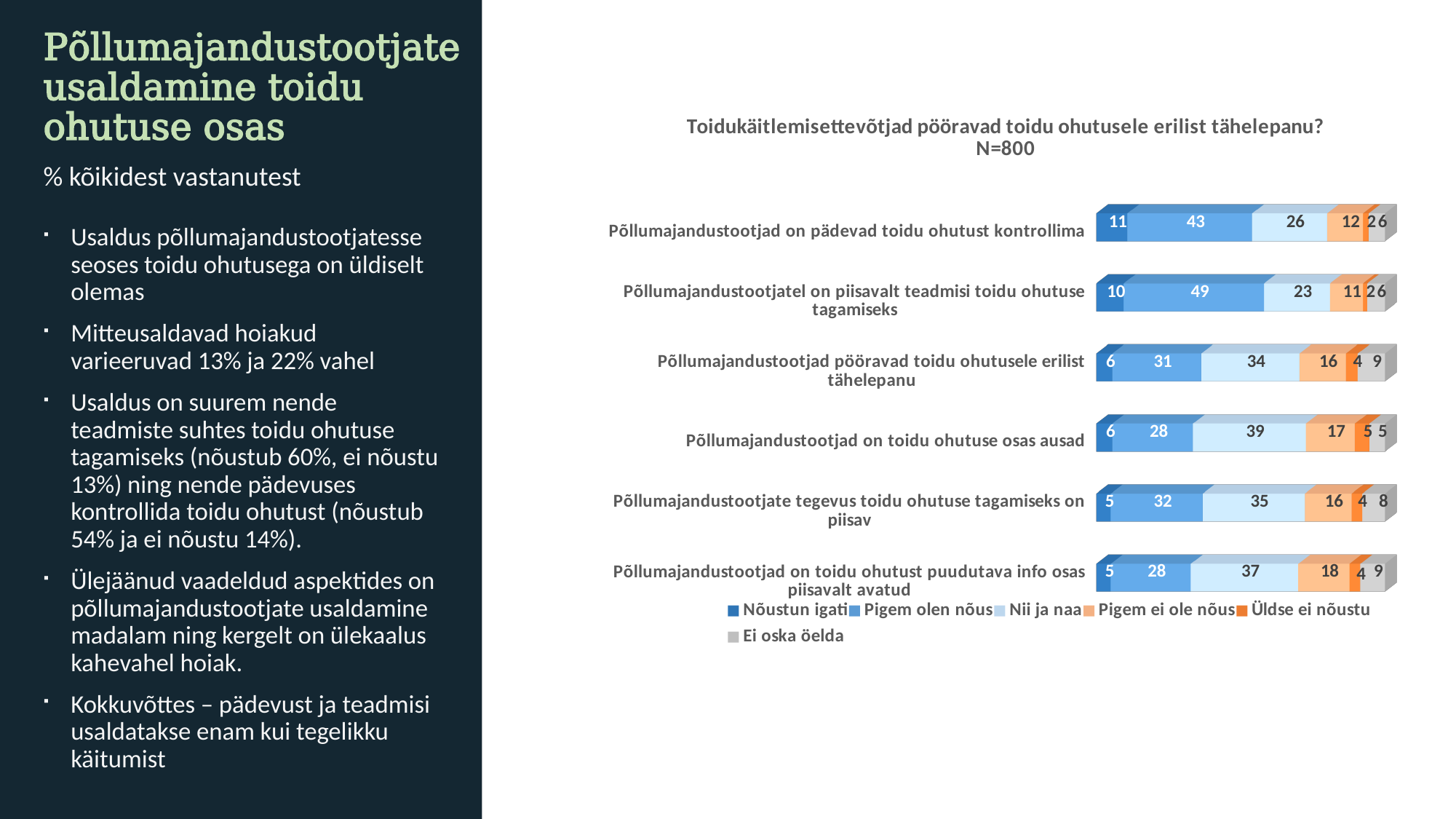
How many categories (statements) are shown in the chart? 6 What is the "Pigem ei ole nõus" value for "Põllumajandustootjad on toidu ohutust puudutava info osas piisavalt avatud"? 18 What is the "Pigem olen nõus" value for "Põllumajandustootjatel on piisavalt teadmisi toidu ohutuse tagamiseks"? 49 Which category has the highest "Nõustun igati" value? Põllumajandustootjad on pädevad toidu ohutust kontrollima What sample size (N) is stated in the chart title? N=800 How many series does the legend list? 6 Which category has the lowest "Nii ja naa" value? Põllumajandustootjatel on piisavalt teadmisi toidu ohutuse tagamiseks Which is larger: the "Ei oska öelda" value for "Põllumajandustootjad pööravad toidu ohutusele erilist tähelepanu" or for "Põllumajandustootjad on toidu ohutuse osas ausad"? Põllumajandustootjad pööravad toidu ohutusele erilist tähelepanu What is the difference between the "Pigem olen nõus" values for "Põllumajandustootjatel on piisavalt teadmisi toidu ohutuse tagamiseks" and "Põllumajandustootjad on pädevad toidu ohutust kontrollima"? 6 What kind of chart is shown on the slide? Stacked bar chart What is the combined total of "Nõustun igati" and "Pigem olen nõus" for "Põllumajandustootjate tegevus toidu ohutuse tagamiseks on piisav"? 37 What is the "Nii ja naa" value for "Põllumajandustootjad on toidu ohutuse osas ausad"? 39